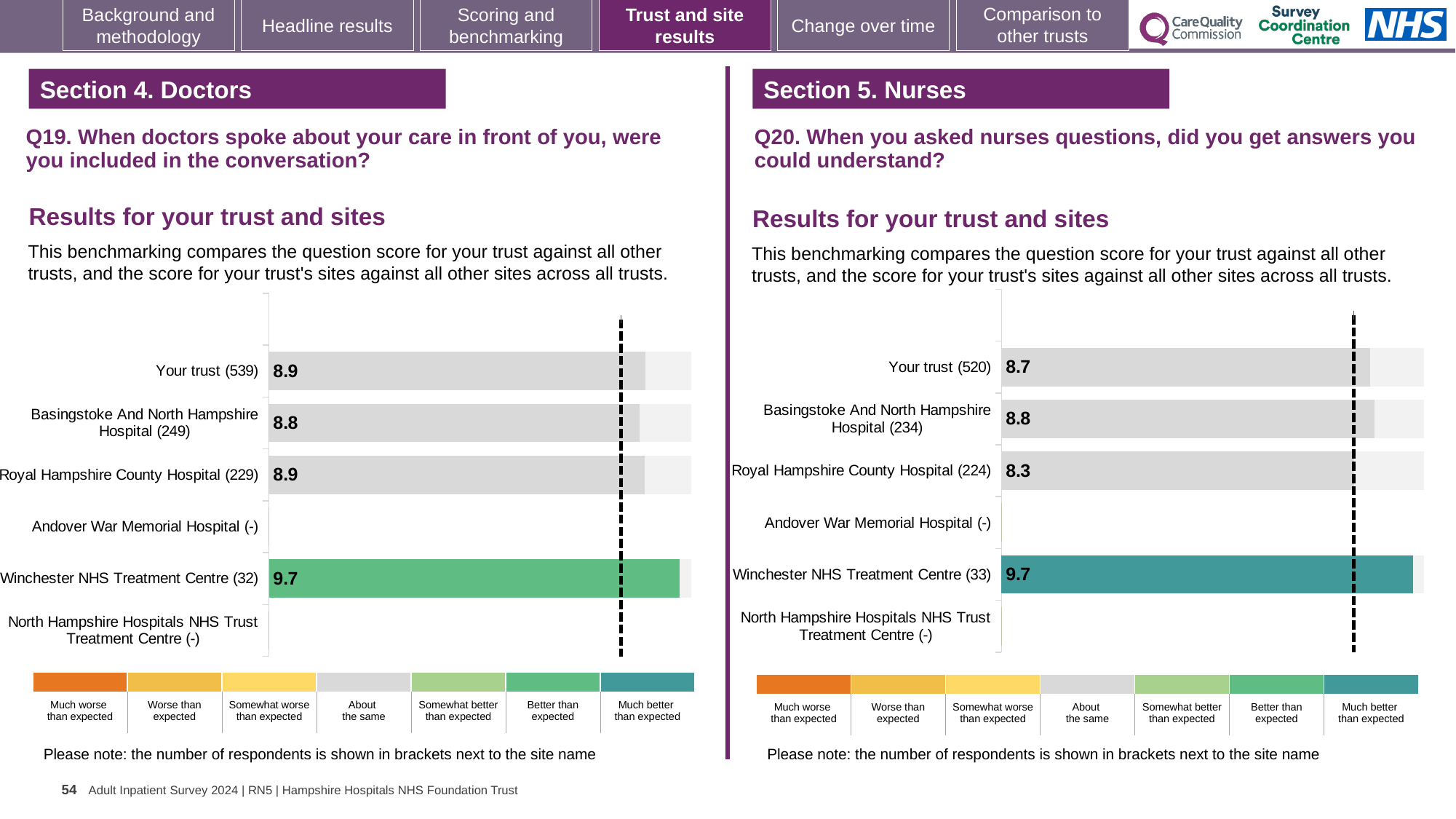
What type of chart is used for the Q19 results (left)? Bar chart On the Q20 chart (right), which is larger: the score for Basingstoke And North Hampshire Hospital (234) or Royal Hampshire County Hospital (224)? Basingstoke And North Hampshire Hospital (234) On the Q20 chart (right), what is the score for Royal Hampshire County Hospital (224)? 8.3 On the Q20 chart (right), what is the difference between the scores for Winchester NHS Treatment Centre (33) and Your trust (520)? 1.0 How many site/trust rows are listed on the Q19 chart (left)? 6 On the Q19 chart (left), what is the score for Winchester NHS Treatment Centre (32)? 9.7 On the Q20 chart (right), what benchmark category does the colour of the Winchester NHS Treatment Centre (33) bar correspond to? Much better than expected On the Q19 chart (left), what is the score for Your trust (539)? 8.9 On the Q19 chart (left), what is the difference between the scores for Winchester NHS Treatment Centre (32) and Basingstoke And North Hampshire Hospital (249)? 0.9 On the Q20 chart (right), what is the score for Your trust (520)? 8.7 On the Q19 chart (left), which site has the highest score? Winchester NHS Treatment Centre (32) On the Q20 chart (right), which site with a printed score has the lowest score? Royal Hampshire County Hospital (224)